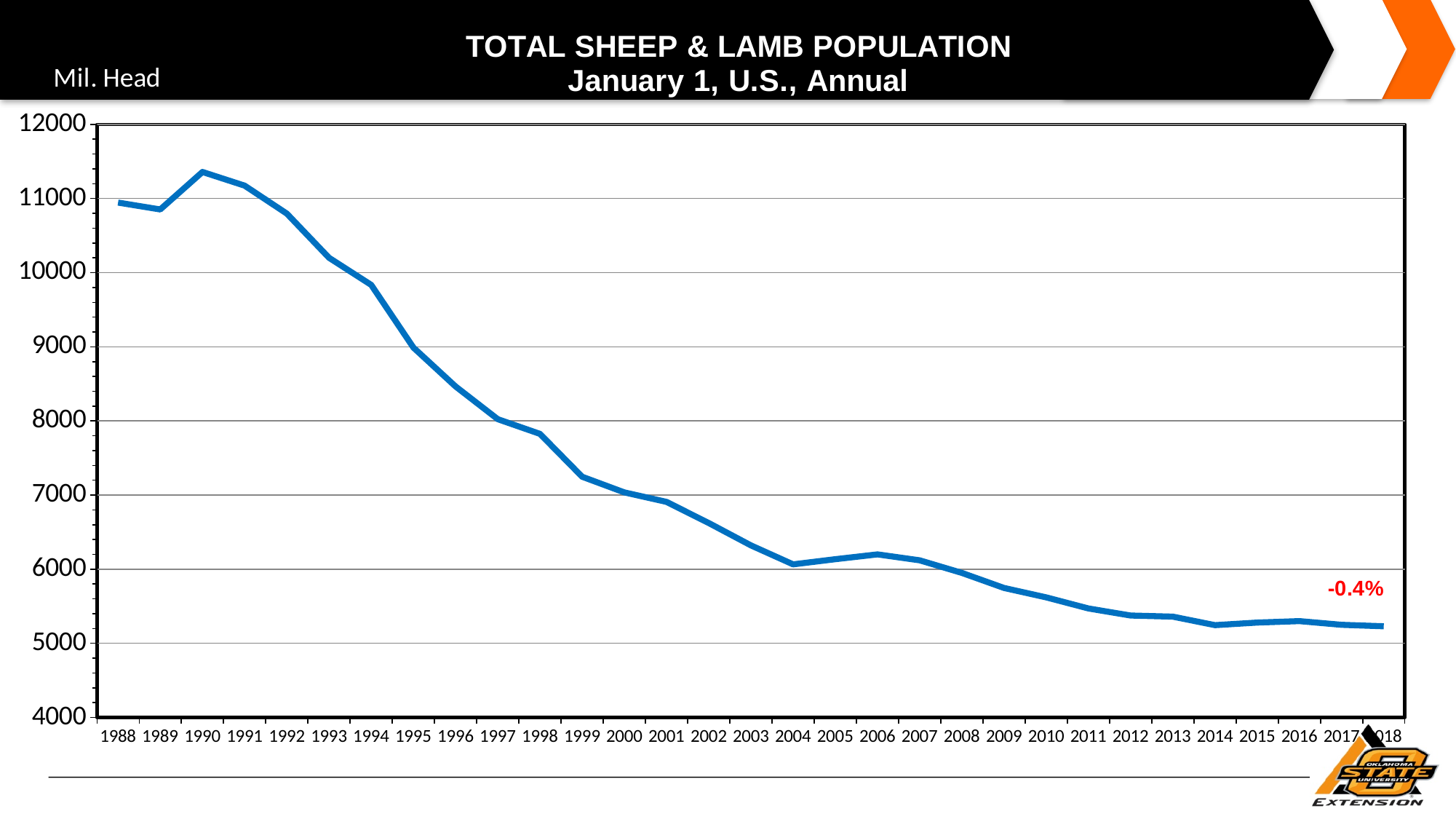
Is the value for 2009 greater or less than 6000? less What percentage change is annotated near the end of the line? -0.4% Is the value for 1990 greater or less than 11000? greater Is the value for 1994 greater or less than 10000? less What kind of chart is shown on the slide? line chart What unit label is shown at the top left of the chart? Mil. Head Do the values generally rise or fall from 1988 to 2018? fall How many years are plotted along the x axis? 31 Which is larger, the value for 1990 or the value for 2000? 1990 Which year has the highest sheep and lamb population? 1990